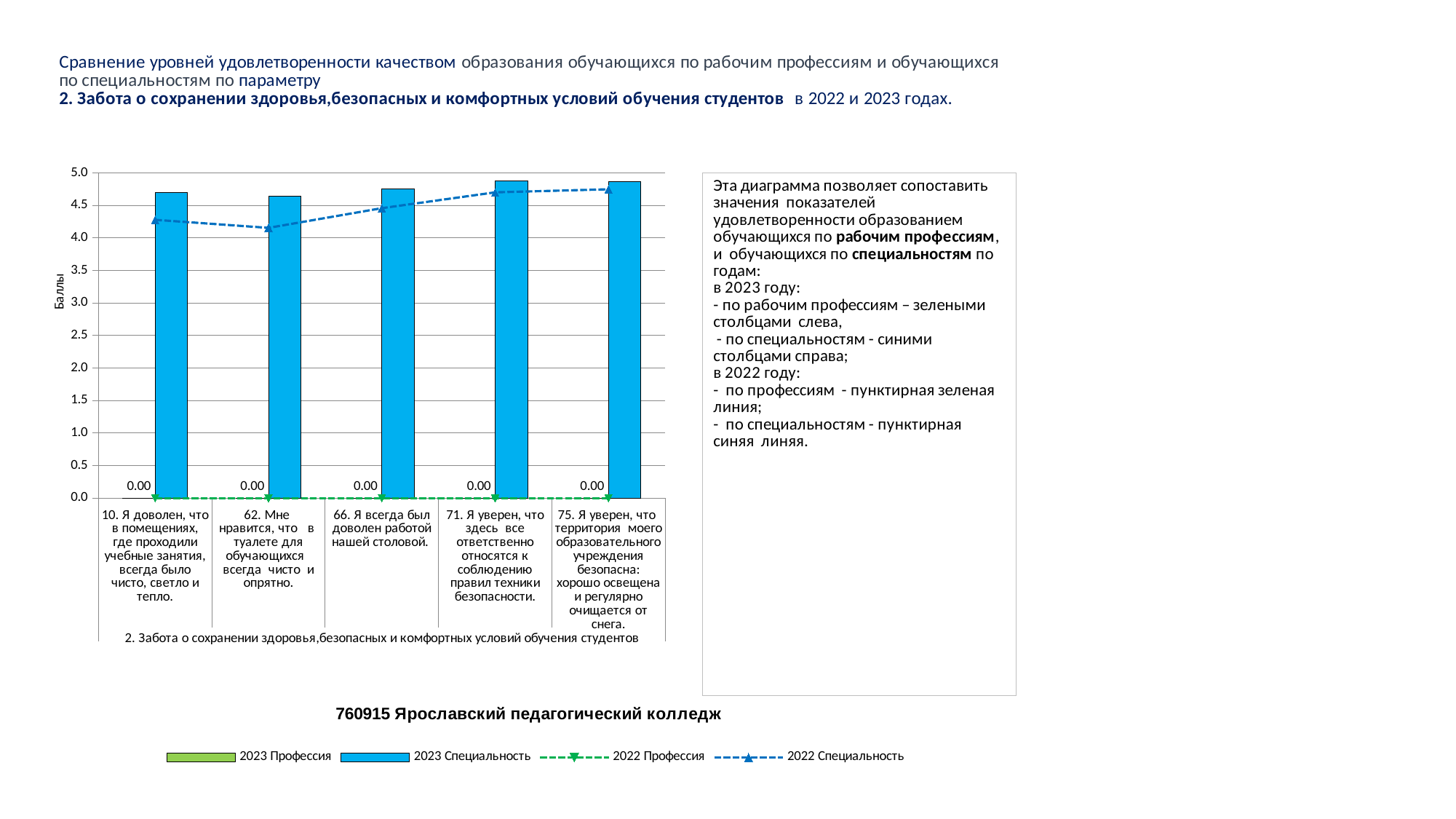
For which category is the 2022 Специальность line at its lowest point? 62. Мне нравится, что в туалете для обучающихся всегда чисто и опрятно. What is the value of the 2023 Профессия series for the category "66. Я всегда был доволен работой нашей столовой."? 0.00 How many series does the chart legend list? 4 Is the 2023 Специальность value for "62. Мне нравится, что в туалете для обучающихся всегда чисто и опрятно." greater or less than 4.5? greater For the category "10. Я доволен, что в помещениях...", which is larger: the 2023 Специальность value or the 2022 Специальность value? 2023 Специальность What is the title of the vertical axis of the chart? Баллы What kind of chart is used to show the 2023 series on the slide? bar chart Is the 2022 Специальность value for "75. Я уверен, что территория моего образовательного учреждения безопасна: хорошо освещена и регулярно очищается от снега." greater or less than 4.5? greater Does the 2022 Специальность line rise or fall from category 62 to category 75? rise How many categories (survey statements) are shown on the x axis of the chart? 5 Is the 2022 Специальность value for "62. Мне нравится, что в туалете для обучающихся всегда чисто и опрятно." greater or less than 4.5? less What is the value of the 2023 Профессия series for the category "10. Я доволен, что в помещениях, где проходили учебные занятия, всегда было чисто, светло и тепло."? 0.00